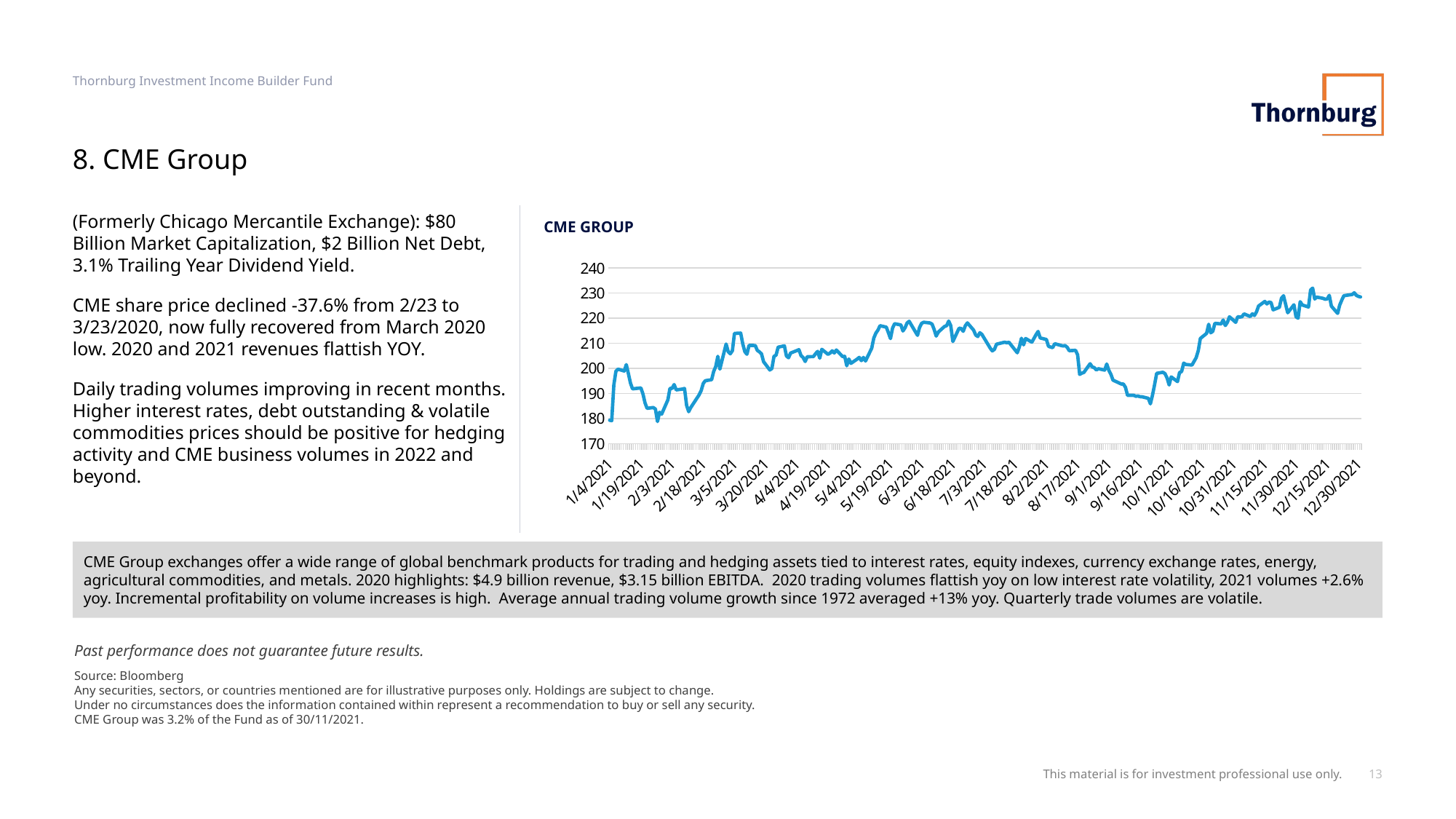
What is the title of the chart? CME GROUP Overall, does the line rise or fall from 1/4/2021 to 12/30/2021? rise What is the highest value shown on the vertical axis? 240 Which date has the larger value, 6/3/2021 or 9/16/2021? 6/3/2021 Is the value at 1/4/2021 greater or less than 190? less Is the value at 9/16/2021 greater or less than 200? less What kind of chart is shown on the slide? line chart Is the value at 12/30/2021 greater or less than 220? greater Which date has the larger value, 1/4/2021 or 12/30/2021? 12/30/2021 How many date labels are shown along the x axis? 25